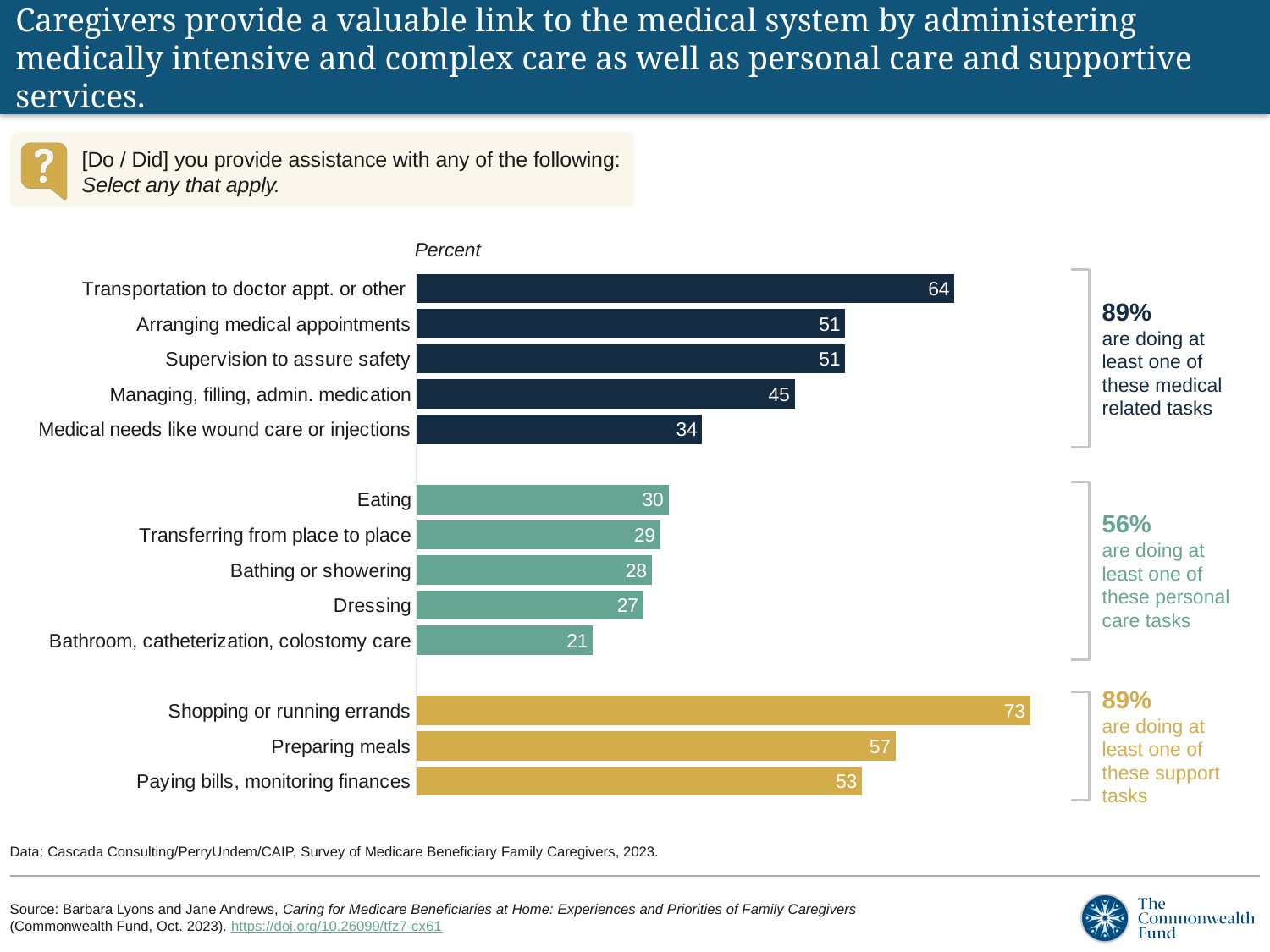
What percent of caregivers provide transportation to doctor appt. or other? 64 According to the annotation, what percent are doing at least one of the personal care tasks? 56% What kind of chart is shown on the slide? Bar chart Which is larger, the value for Managing, filling, admin. medication or the value for Medical needs like wound care or injections? Managing, filling, admin. medication What is the value for Shopping or running errands? 73 Which category has the highest value on the chart? Shopping or running errands What is the value for Bathroom, catheterization, colostomy care? 21 Which category has the lowest value on the chart? Bathroom, catheterization, colostomy care What is the difference between the values for Transportation to doctor appt. or other and Eating? 34 What is the difference between the values for Preparing meals and Paying bills, monitoring finances? 4 What unit label is shown above the chart? Percent How many categories are plotted on the chart? 13